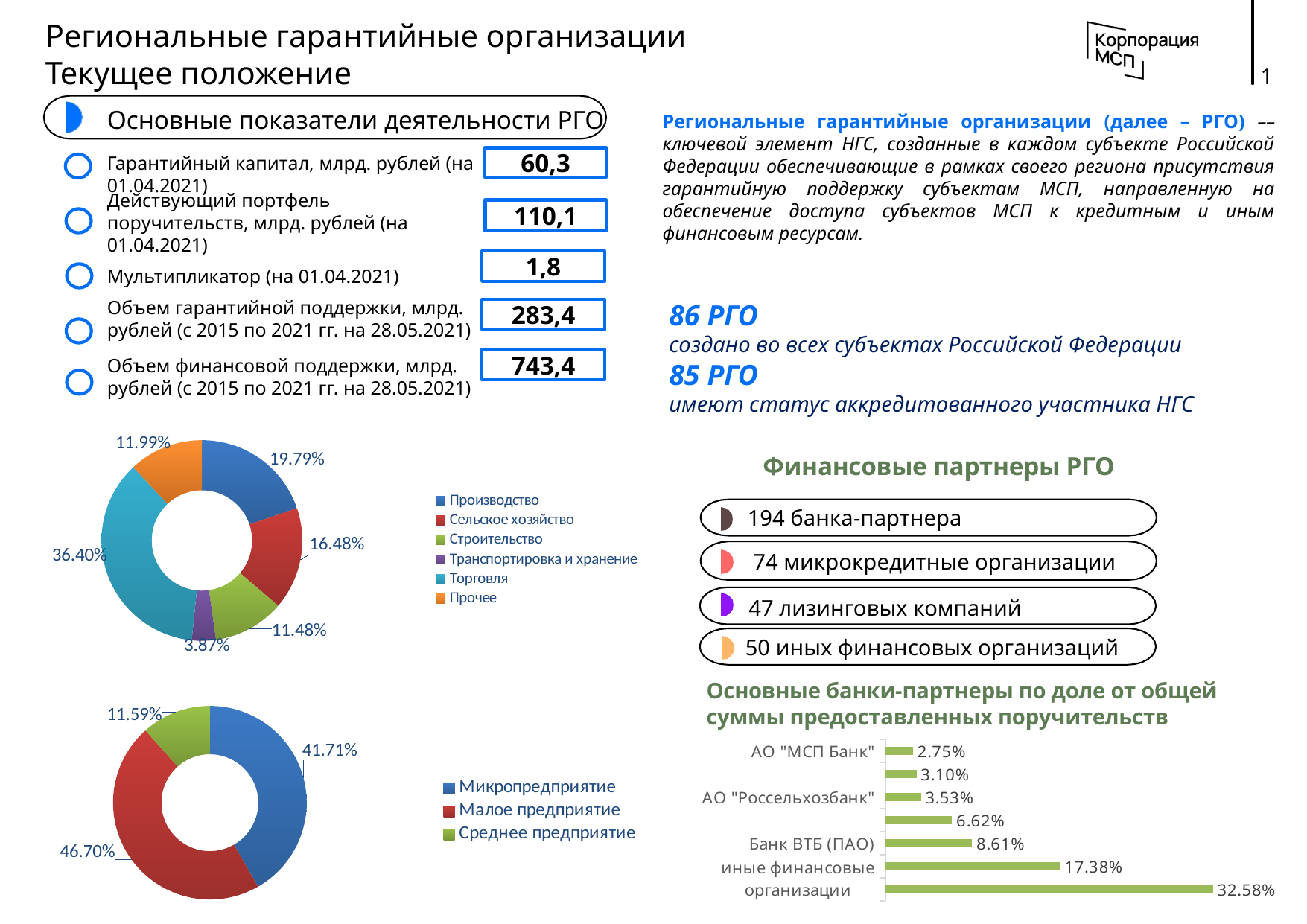
In the top-left donut chart, what share does Торговля have? 36.40% In the bottom-left donut chart, what share does Среднее предприятие have? 11.59% In the top-left donut chart, what share does Производство have? 19.79% In the top-left donut chart, which category has the largest share? Торговля How many categories does the legend of the top-left donut chart list? 6 In the bottom-left donut chart, which is larger: Микропредприятие or Малое предприятие? Малое предприятие In the bar chart 'Основные банки-партнеры по доле от общей суммы предоставленных поручительств', what is the value for Банк ВТБ (ПАО)? 8.61% In the top-left donut chart, which category has the smallest share? Транспортировка и хранение In the bar chart 'Основные банки-партнеры по доле от общей суммы предоставленных поручительств', what is the value for АО "МСП Банк"? 2.75% In the bottom-left donut chart, what share does Малое предприятие have? 46.70% What kind of chart is 'Основные банки-партнеры по доле от общей суммы предоставленных поручительств'? bar chart In the top-left donut chart, what is the difference between the shares of Сельское хозяйство and Строительство? 5.00%